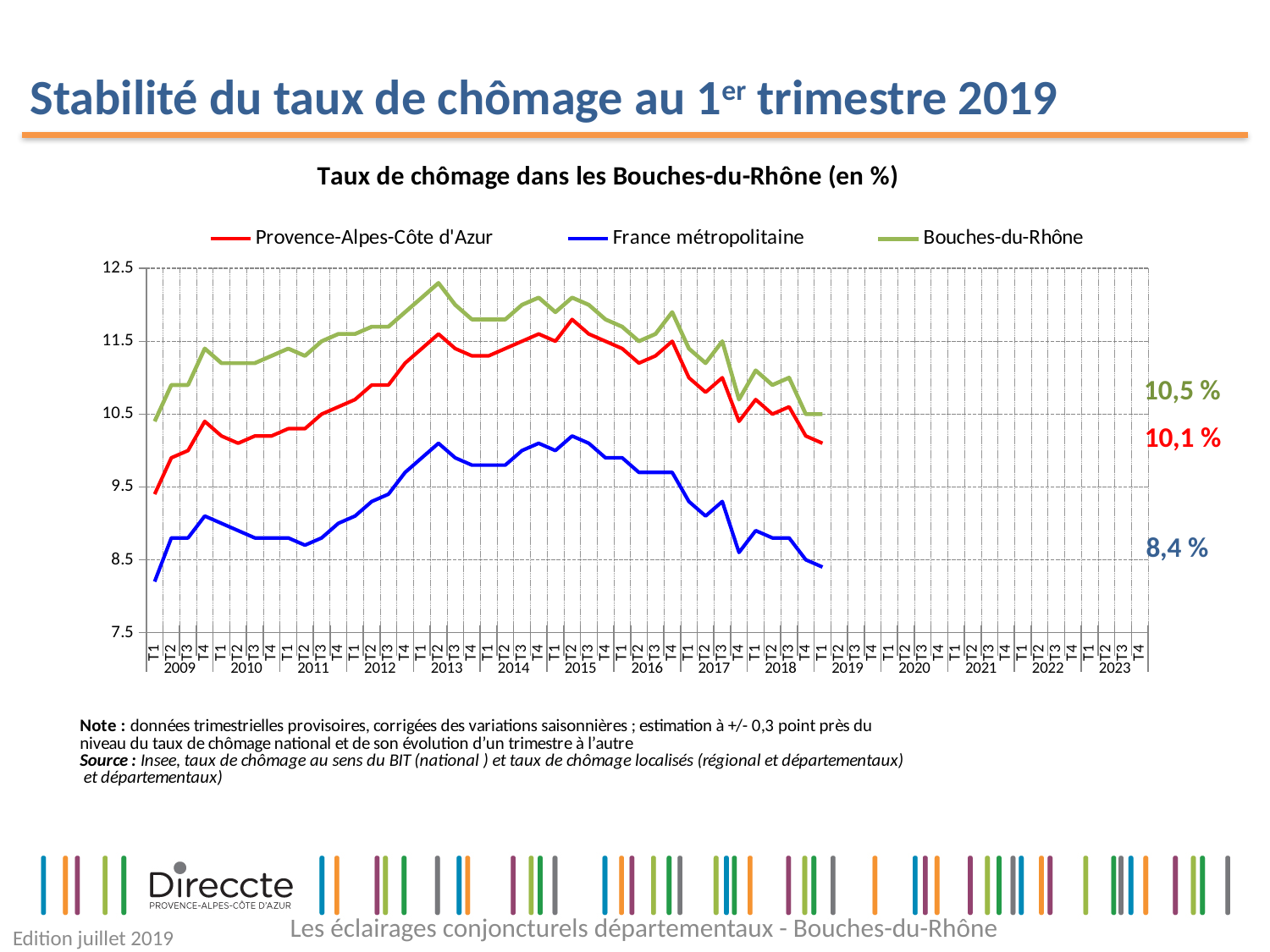
Is the value for France métropolitaine at T1 2009 greater or less than 8.5? less How many series does the legend list? 3 What is the latest value shown for Bouches-du-Rhône? 10,5 % Which series has the highest values across the whole period? Bouches-du-Rhône What is the difference between the latest values for Bouches-du-Rhône and France métropolitaine? 2,1 points Does the France métropolitaine series rise or fall between T2 2015 and T1 2019? Fall Which series has the highest latest value, Bouches-du-Rhône or France métropolitaine? Bouches-du-Rhône Which series has the lowest values across the whole period? France métropolitaine What kind of chart is shown? Line chart What is the difference between the latest values for Bouches-du-Rhône and Provence-Alpes-Côte d'Azur? 0,4 point What is the latest value shown for France métropolitaine? 8,4 % What is the latest value shown for Provence-Alpes-Côte d'Azur? 10,1 %